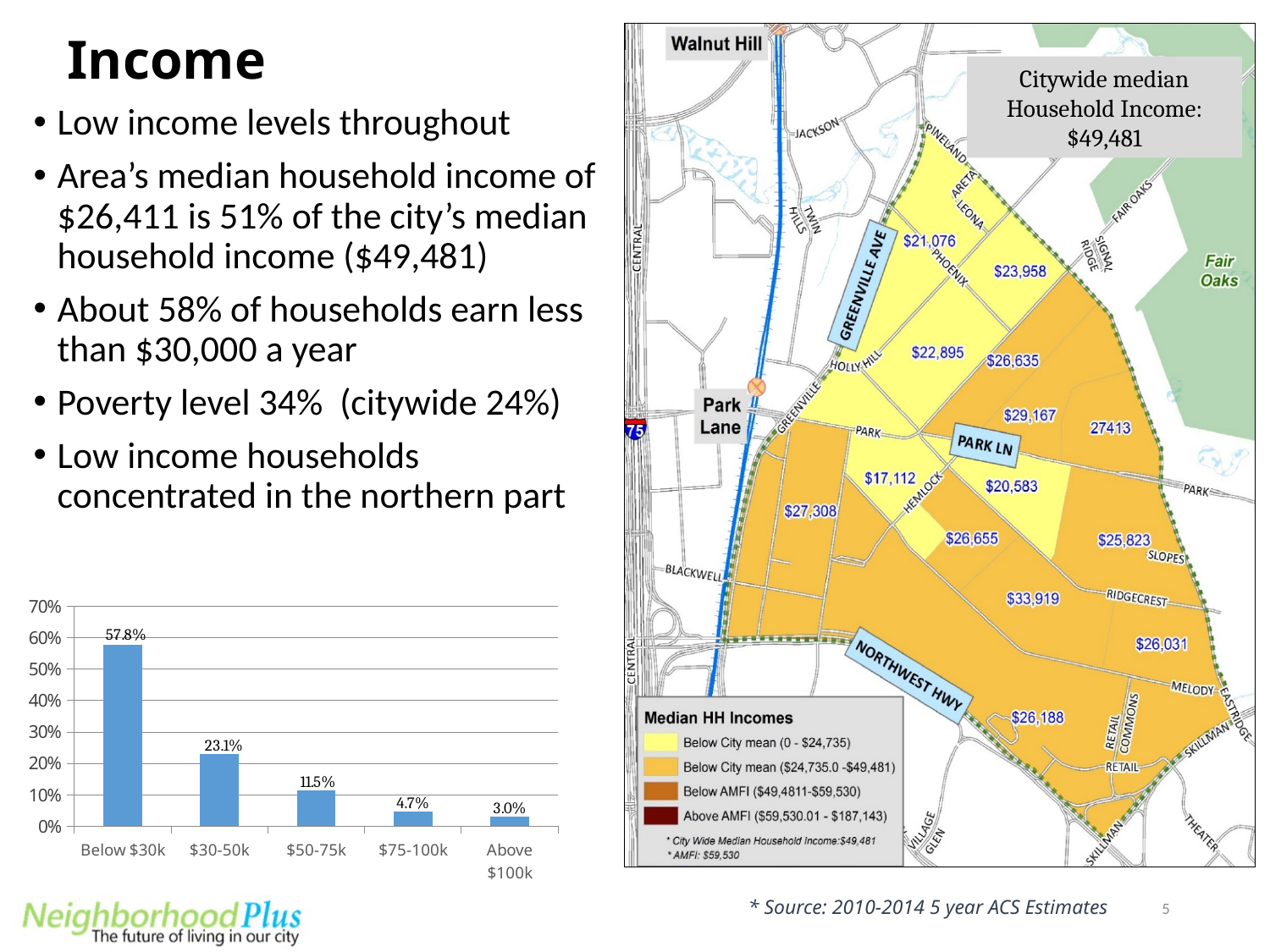
What type of chart is shown at the bottom left of the slide? Bar chart How many income categories are shown on the x axis of the bar chart? 5 Do the values in the bar chart rise or fall moving from left to right along the x axis? Fall Which income category has the highest value in the bar chart? Below $30k What percentage of households earn below $30k according to the bar chart? 57.8% Which income category has the lowest value in the bar chart? Above $100k What is the difference between the $75-100k and Above $100k values in the bar chart? 1.7% What is the value shown for the $50-75k category in the bar chart? 11.5% What is the difference between the Below $30k and $30-50k values in the bar chart? 34.7% What is the value shown for the Above $100k category in the bar chart? 3.0% What is the value shown for the $30-50k category in the bar chart? 23.1% Which is larger in the bar chart, the value for $50-75k or the value for $75-100k? $50-75k